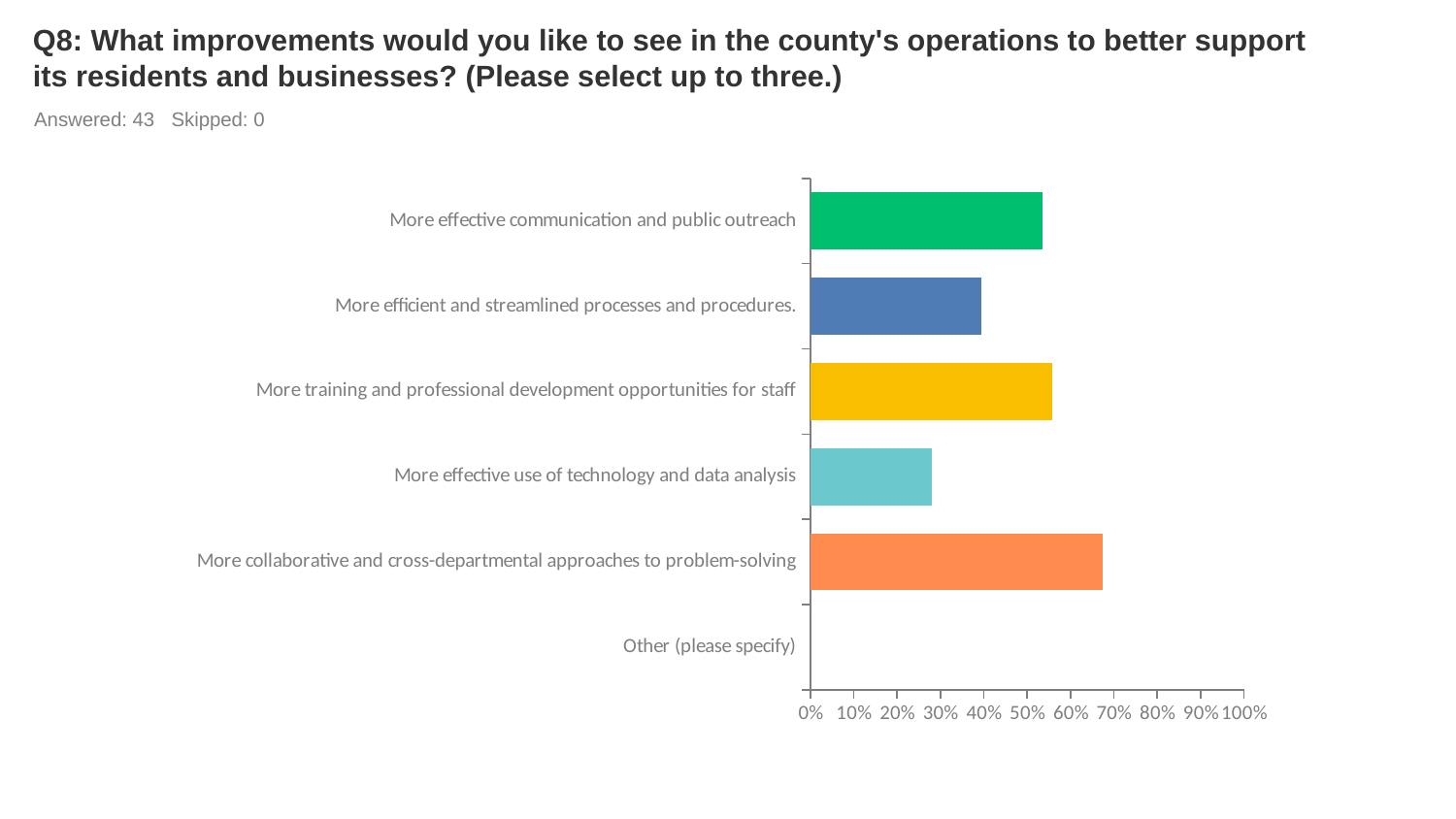
Which category has the highest value? More collaborative and cross-departmental approaches to problem-solving Is the value for "More effective use of technology and data analysis" greater or less than 30%? less What kind of chart is shown on the slide? bar chart Is the value for "More training and professional development opportunities for staff" greater or less than 50%? greater Which category has the lowest value? Other (please specify) Which is larger: the value for "More effective communication and public outreach" or for "More efficient and streamlined processes and procedures."? More effective communication and public outreach Which is larger: the value for "More effective use of technology and data analysis" or for "More efficient and streamlined processes and procedures."? More efficient and streamlined processes and procedures. Is the value for "More effective communication and public outreach" greater or less than 50%? greater How many categories (answer options) are shown on the chart? 6 How many respondents answered this question according to the slide? 43 What is the value for "Other (please specify)"? 0%